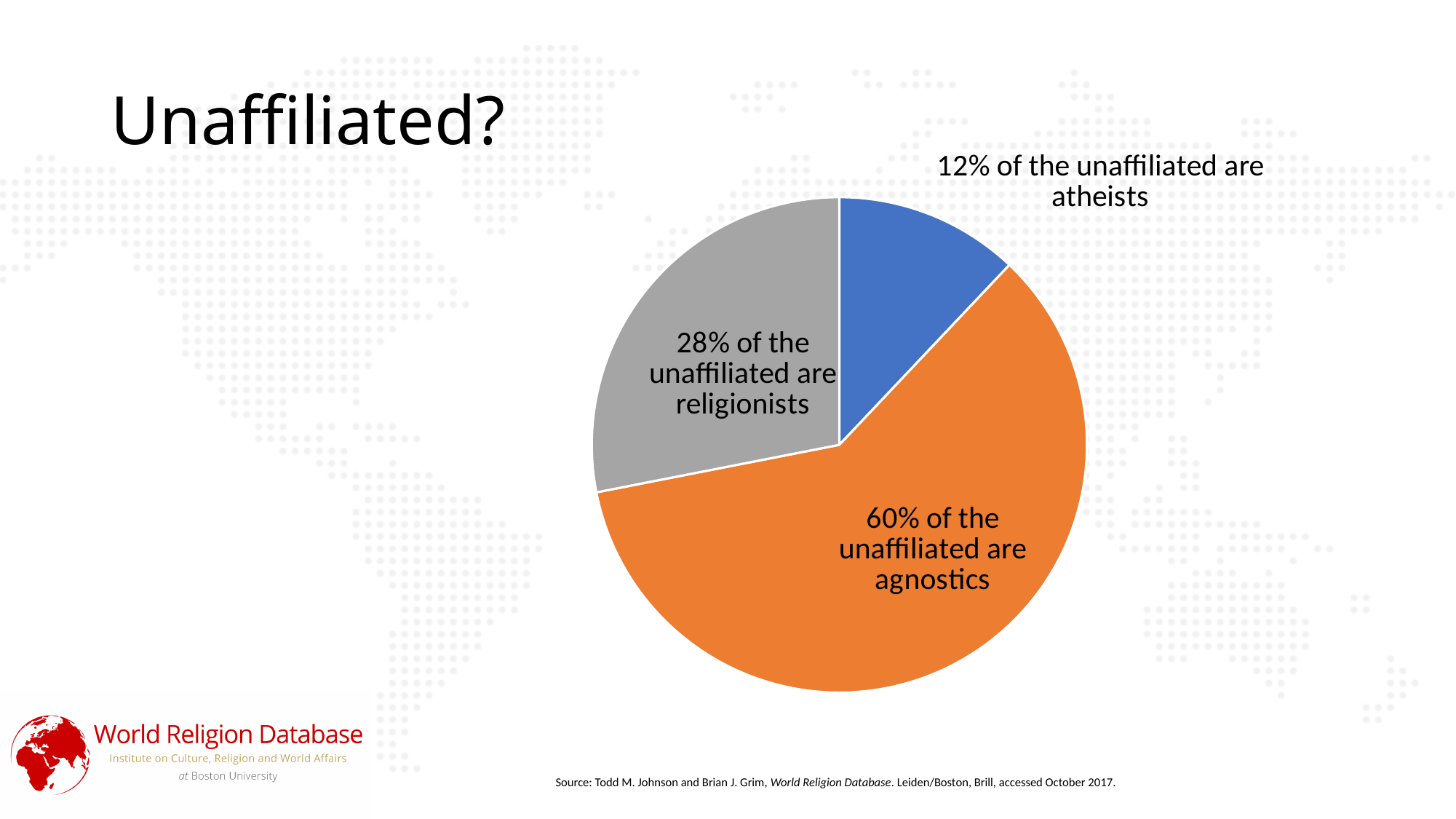
How many percentage points larger is the agnostics slice than the religionists slice? 32 How many slices does the pie chart have? 3 What share of the unaffiliated are agnostics? 60% What is the title of the slide? Unaffiliated? What share of the unaffiliated are religionists? 28% What colour is the slice for agnostics? orange Which group makes up the largest slice of the pie? agnostics What share of the unaffiliated are atheists? 12% Which group makes up the smallest slice of the pie? atheists Which slice is larger, religionists or atheists? religionists How many percentage points larger is the religionists slice than the atheists slice? 16 What kind of chart is shown on the slide? pie chart